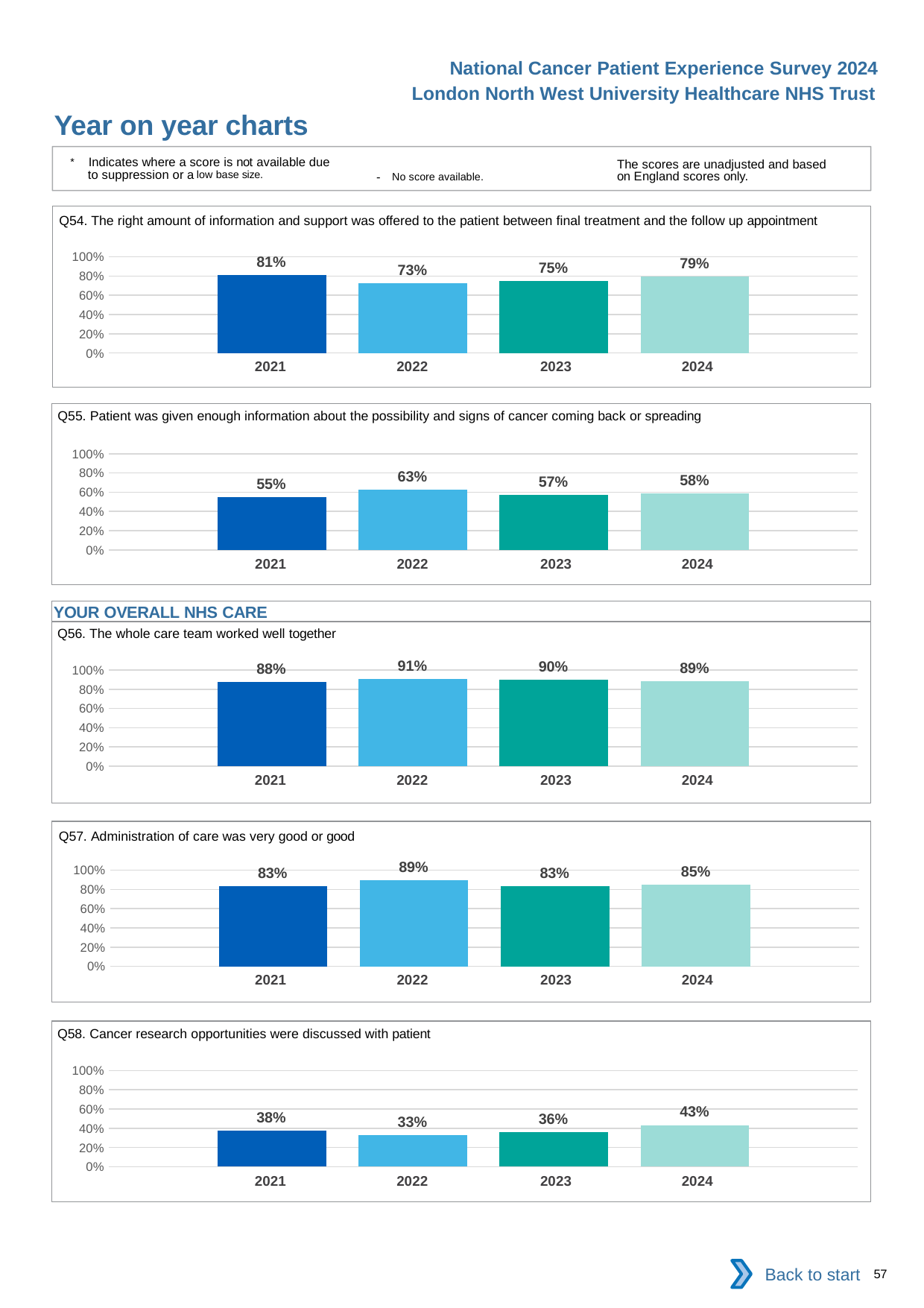
In the Q54 chart, which year has the lowest value? 2022 In the Q55 chart, what is the value for 2024? 58% In the Q54 chart, what is the value for 2021? 81% In the Q57 chart, what is the difference between the 2022 and 2023 values? 6% In the Q56 chart, how many years are plotted? 4 In the Q55 chart, what is the difference between the 2022 and 2021 values? 8% In the Q58 chart, what is the value for 2024? 43% In the Q55 chart, which year has the highest value? 2022 In the Q57 chart, which is larger, the value for 2022 or the value for 2024? 2022 In the Q58 chart, is the value for 2022 greater or less than 40%? less In the Q56 chart, what is the value for 2022? 91% What kind of chart is the Q58 chart? bar chart